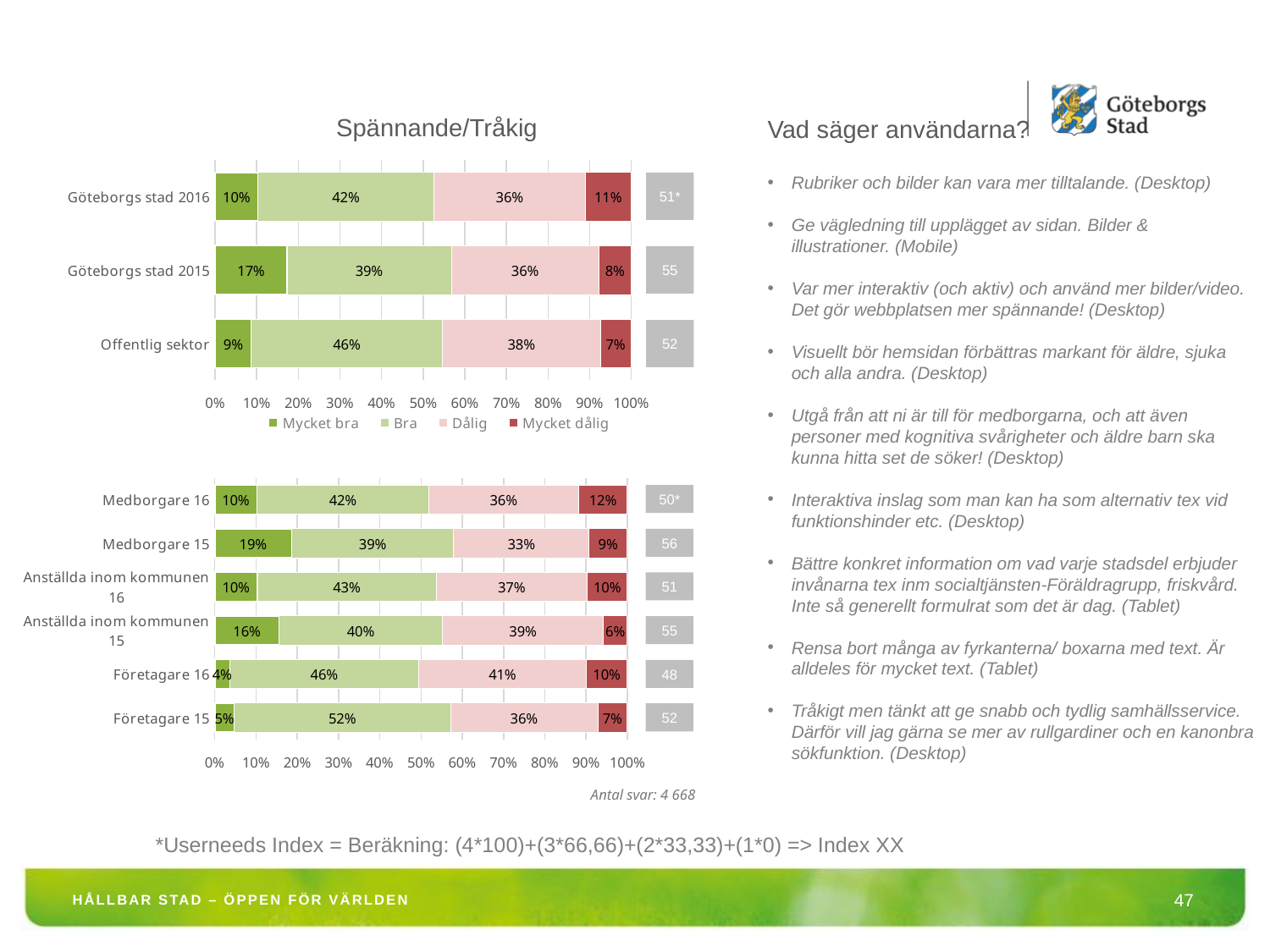
In the top chart titled "Spännande/Tråkig", how many series does the legend list? 4 In the bottom chart, how many categories are shown? 6 In the top chart titled "Spännande/Tråkig", what is the "Mycket bra" value for Göteborgs stad 2015? 17% In the top chart titled "Spännande/Tråkig", which category has the highest "Mycket dålig" value? Göteborgs stad 2016 In the bottom chart, what is the "Dålig" value for Anställda inom kommunen 15? 39% In the bottom chart, which category has the lowest "Mycket bra" value? Företagare 16 In the top chart titled "Spännande/Tråkig", what is the difference between the "Mycket bra" values for Göteborgs stad 2015 and Göteborgs stad 2016? 7% What kind of chart is the bottom chart? Stacked bar chart In the top chart titled "Spännande/Tråkig", how many categories are shown? 3 In the bottom chart, what is the "Bra" value for Företagare 15? 52% In the bottom chart, which is larger: the "Mycket dålig" value for Medborgare 16 or for Företagare 15? Medborgare 16 In the top chart titled "Spännande/Tråkig", what is the "Bra" value for Offentlig sektor? 46%